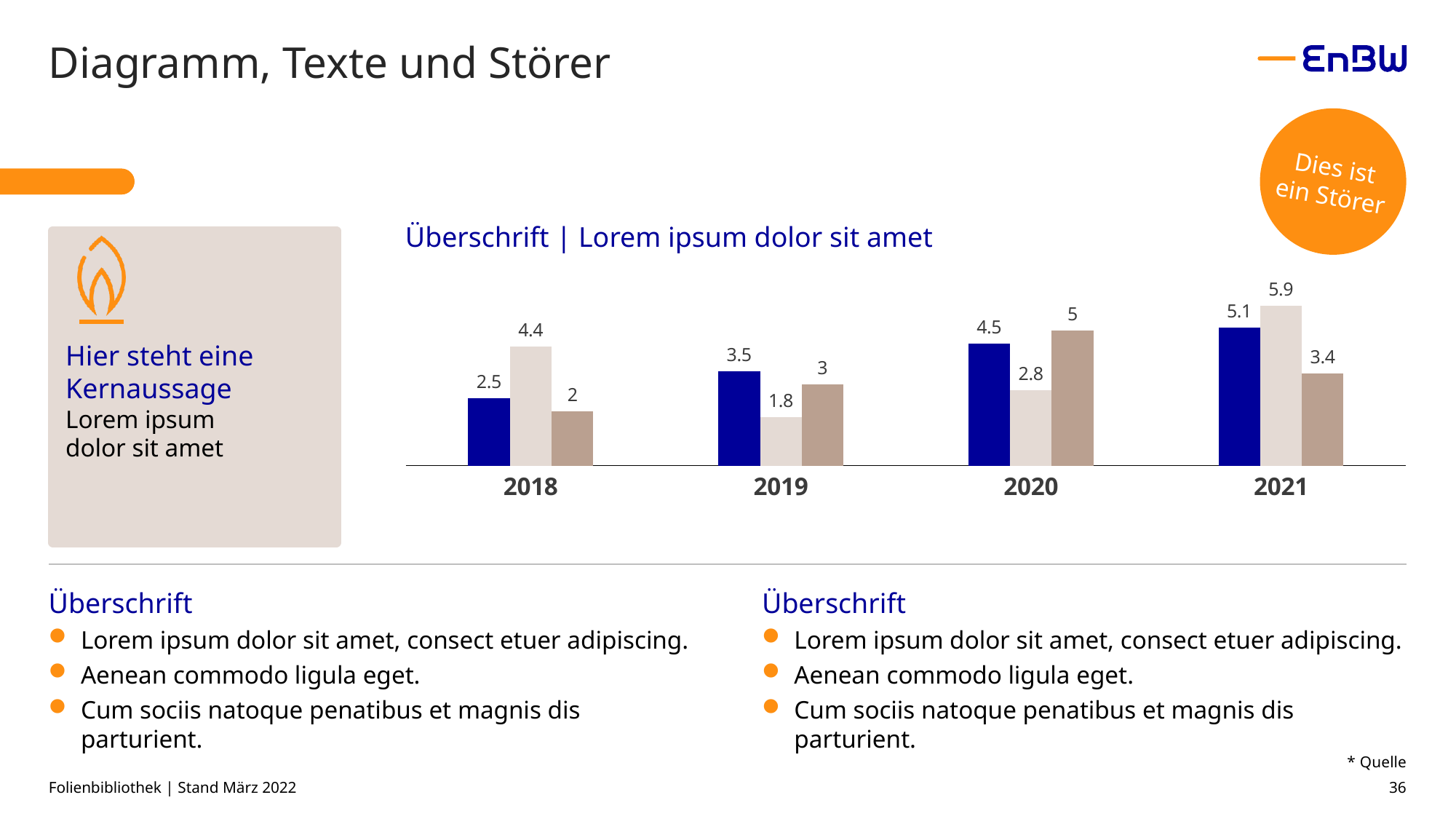
What is the value of the light beige bar for 2019? 1.8 How many year categories are shown on the x axis of the chart? 4 Do the dark blue bar values rise or fall from 2018 to 2021? rise What is the difference between the light beige bar and the dark blue bar in 2021? 0.8 In which year is the dark blue bar highest? 2021 What type of chart is shown on the slide? bar chart What is the value of the light beige bar for 2021? 5.9 What is the value of the dark blue bar for 2018? 2.5 How many bars are shown for each year in the chart? 3 What is the value of the brown bar for 2020? 5 Which is larger in 2020: the dark blue bar or the brown bar? the brown bar In which year is the brown bar lowest? 2018